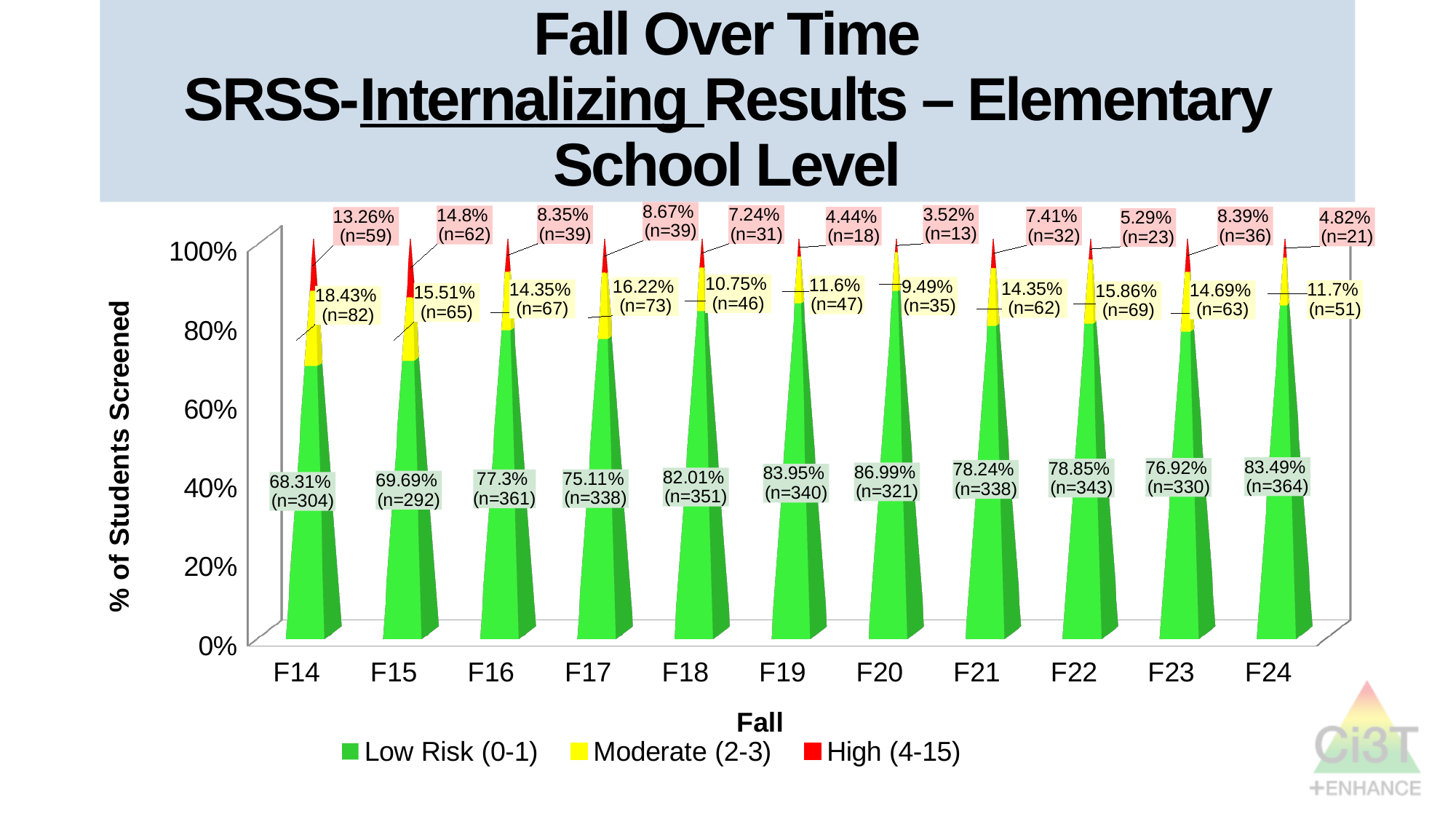
Which fall has the highest High (4-15) percentage? F15 Which fall has the highest Low Risk (0-1) percentage? F20 How many students were in the Moderate (2-3) category in F17? n=73 What percentage of students were Low Risk (0-1) in F20? 86.99% Which colour represents the High (4-15) category in the legend? Red What is the difference in percentage points between the Low Risk (0-1) values for F20 and F14? 18.68 Which has the larger High (4-15) percentage, F18 or F19? F18 How many fall time points are shown on the x axis? 11 What percentage of students were High (4-15) in F14? 13.26% Which fall has the lowest Low Risk (0-1) percentage? F14 How many series does the legend list? 3 What kind of chart is shown on the slide? Stacked bar chart